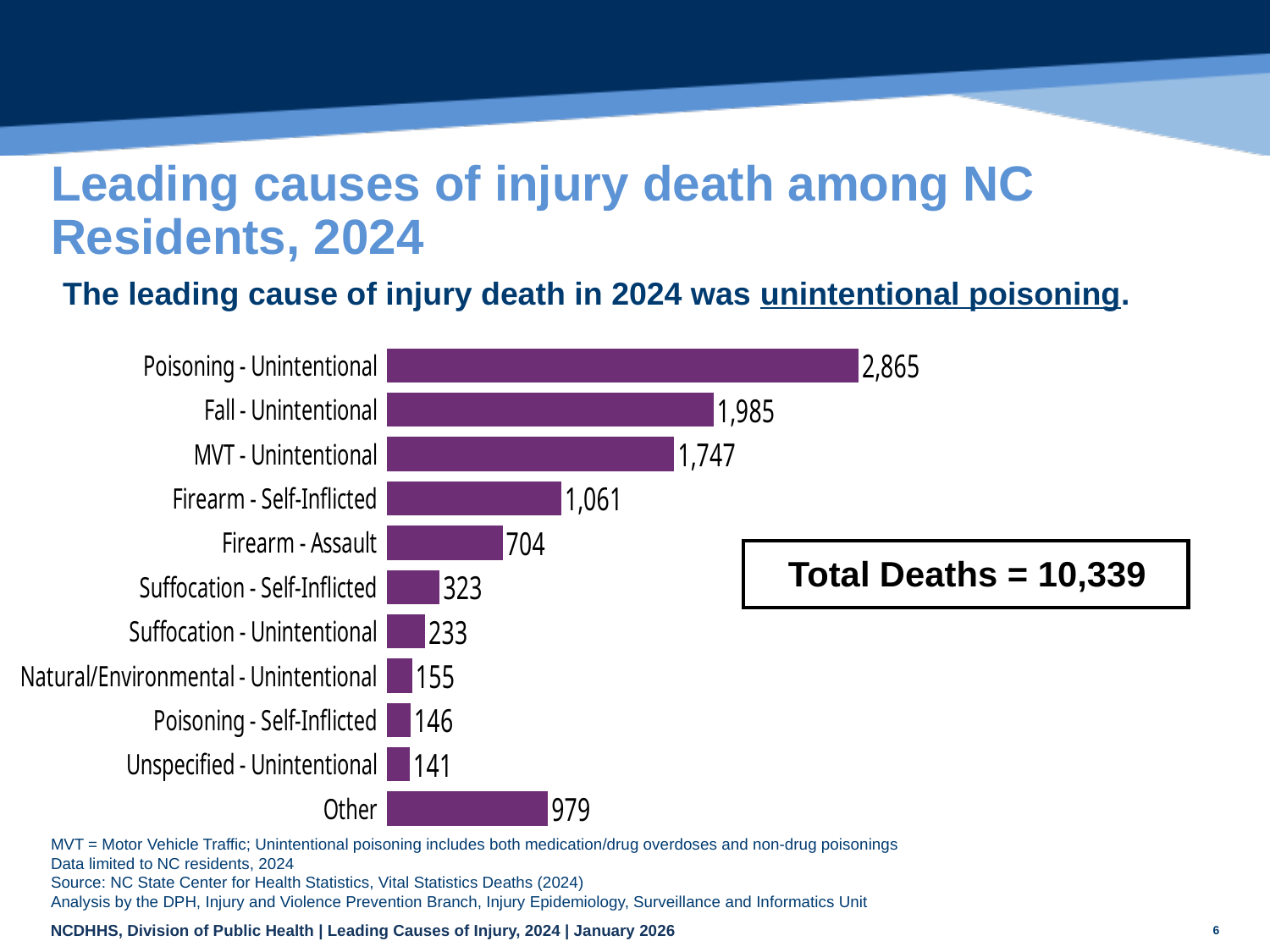
What is the difference between Fall - Unintentional and MVT - Unintentional? 238 How many deaths are shown for Poisoning - Unintentional? 2,865 Which category has the lowest value? Unspecified - Unintentional What kind of chart is shown on the slide? Bar chart Which is larger, Firearm - Assault or Other? Other What is the difference between Poisoning - Unintentional and Fall - Unintentional? 880 What is the value for Suffocation - Unintentional? 233 Which is larger, Suffocation - Self-Inflicted or Natural/Environmental - Unintentional? Suffocation - Self-Inflicted Which category has the highest value? Poisoning - Unintentional How many categories are shown in the chart? 11 What total number of deaths is stated in the box next to the chart? 10,339 What is the value for Firearm - Self-Inflicted? 1,061